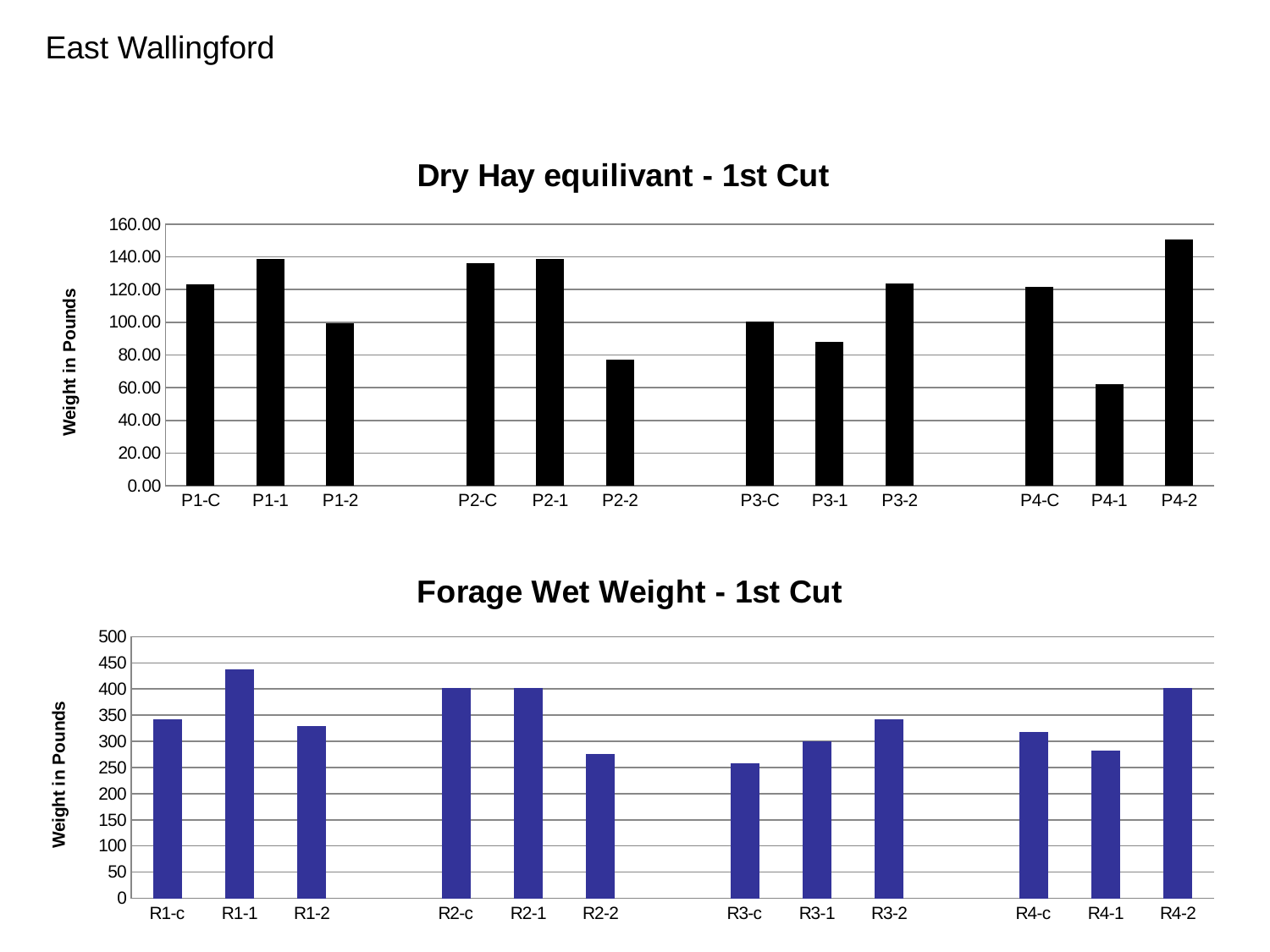
In the Dry Hay equilivant - 1st Cut chart, which category has the highest value? P4-2 In the Dry Hay equilivant - 1st Cut chart, which is larger, P1-1 or P1-2? P1-1 What is the y-axis label of the Forage Wet Weight - 1st Cut chart? Weight in Pounds In the Forage Wet Weight - 1st Cut chart, which category has the highest value? R1-1 How many bars are plotted in the Dry Hay equilivant - 1st Cut chart? 12 In the Dry Hay equilivant - 1st Cut chart, is the value for P4-1 greater or less than 80.00? less In the Dry Hay equilivant - 1st Cut chart, is the value for P4-2 greater or less than 140.00? greater In the Forage Wet Weight - 1st Cut chart, is the value for R2-2 greater or less than 300? less In the Forage Wet Weight - 1st Cut chart, which is larger, R4-1 or R4-2? R4-2 In the Forage Wet Weight - 1st Cut chart, which category has the lowest value? R3-c In the Dry Hay equilivant - 1st Cut chart, which category has the lowest value? P4-1 What kind of chart is the Forage Wet Weight - 1st Cut chart? bar chart